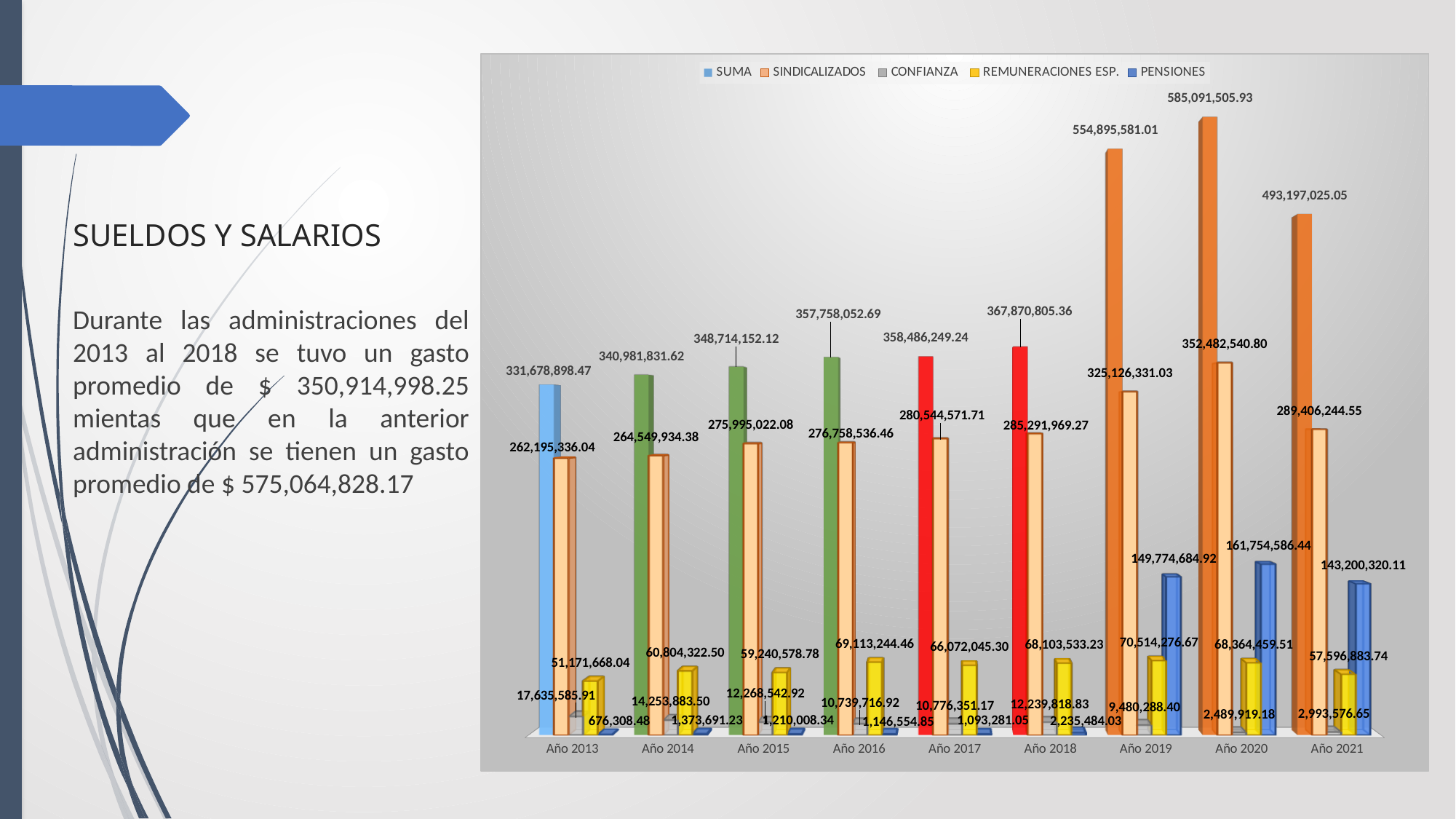
Which year has the highest SUMA value? Año 2020 Which is larger, the SINDICALIZADOS value for Año 2020 or for Año 2021? Año 2020 What is the CONFIANZA value for Año 2013? 17,635,585.91 What is the SINDICALIZADOS value for Año 2019? 325,126,331.03 Which year has the lowest SUMA value? Año 2013 What is the PENSIONES value for Año 2021? 143,200,320.11 How many years are shown on the x axis? 9 What is the SUMA value for Año 2020? 585,091,505.93 What is the difference between the SUMA values for Año 2020 and Año 2019? 30,195,924.92 How many series does the legend list? 5 What kind of chart is shown on the slide? Bar chart Does the SUMA value rise or fall from Año 2013 to Año 2018? Rise